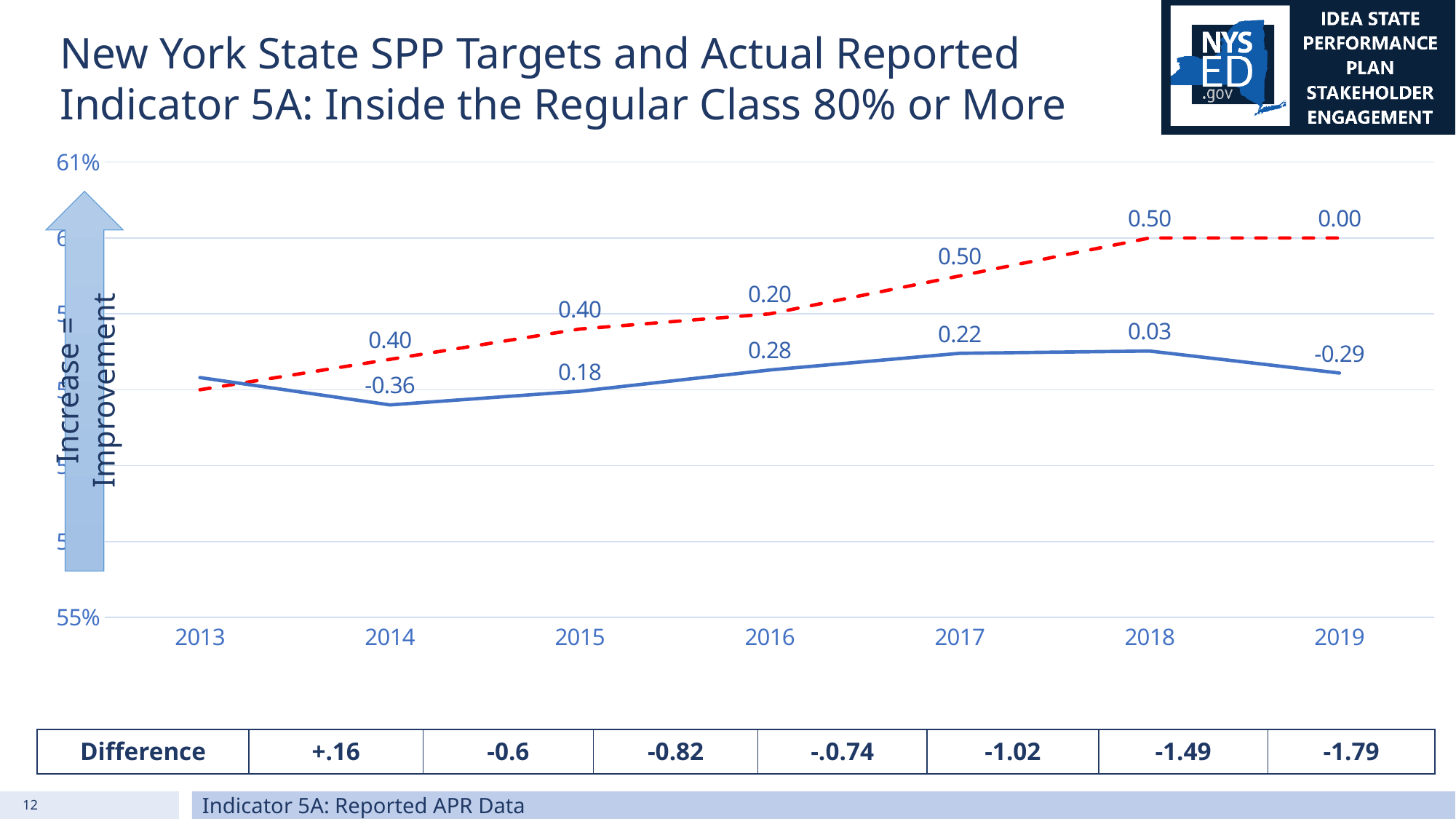
What is the data label on the blue solid line at 2014? -0.36 What is the data label on the blue solid line at 2019? -0.29 In the Difference row of the table below the chart, what is the value in the first (2013) column? +.16 In the Difference row of the table below the chart, what is the value in the last (2019) column? -1.79 What is the data label on the red dashed line at 2019? 0.00 How many years are shown on the x axis of the chart? 7 What is the data label on the red dashed line at 2017? 0.50 What type of chart is shown on the slide? line chart What is the difference between the red dashed line's label (0.50) and the blue solid line's label (0.03) at 2018? 0.47 In 2019, which line is higher on the chart, the red dashed line or the blue solid line? red dashed line Does the red dashed line rise or fall from 2013 to 2018? rise Which year has the highest data label on the blue solid line? 2016